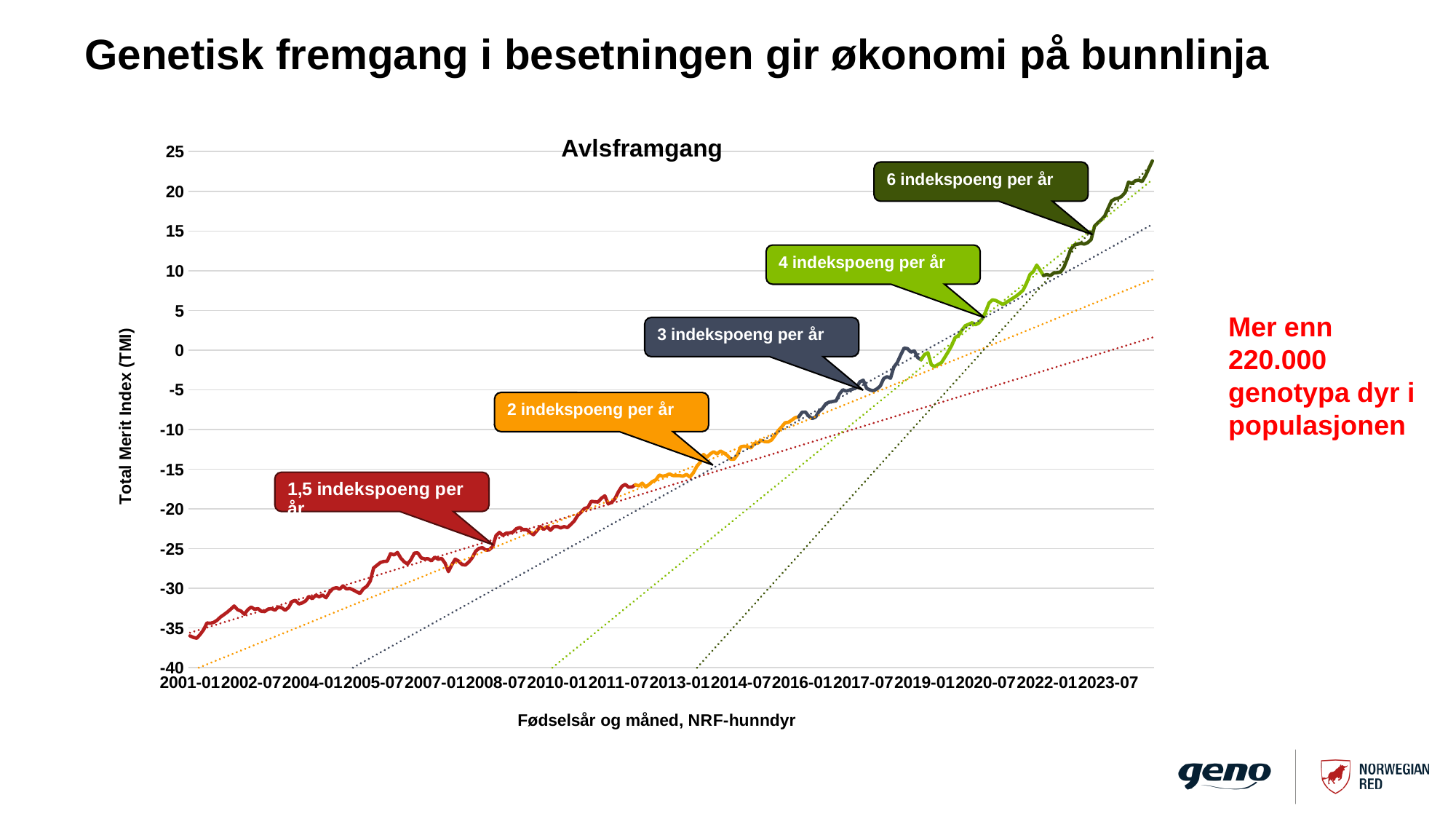
Is the value for 2023-07 greater or less than 20? less How many callout labels indicating index points per year are shown on the chart? 5 Which of the two dates has the higher Total Merit Index, 2004-01 or 2017-07? 2017-07 Is the value for 2001-01 greater or less than -30? less What is the title of the chart? Avlsframgang What annual gain does the callout at the most recent part of the line state? 6 indekspoeng per år What is the label of the vertical axis of the chart? Total Merit Index (TMI) Is the value for 2010-01 greater or less than -20? less What kind of chart is shown on the slide? line chart Does the Total Merit Index rise or fall along the x axis from 2001-01 to 2023-07? rise